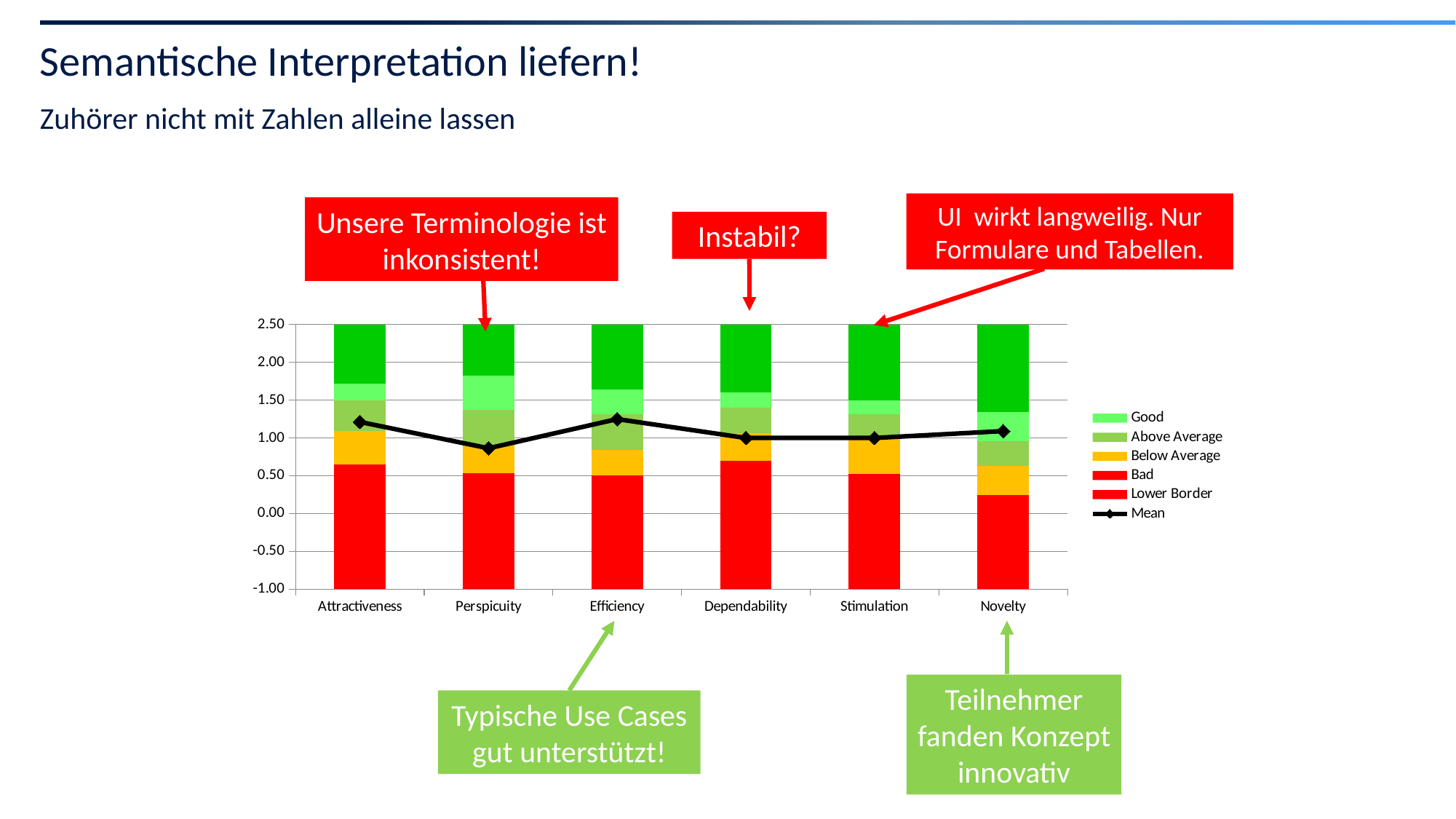
Which has the larger Mean value, Efficiency or Perspicuity? Efficiency Which has the larger Mean value, Attractiveness or Perspicuity? Attractiveness Does the Mean line rise or fall from Attractiveness to Perspicuity? It falls What is the highest value shown on the chart's y axis? 2.50 Which legend entry is drawn as a black line with diamond markers? Mean Which category has the lowest Mean value? Perspicuity What kind of chart is shown on the slide? A stacked bar chart with a line for the Mean Is the Mean value for Efficiency greater or less than 1.50? less Is the Mean value for Perspicuity greater or less than 1.00? less How many series does the chart's legend list? 6 Is the Mean value for Attractiveness greater or less than 1.00? greater How many categories are shown on the x axis of the chart? 6